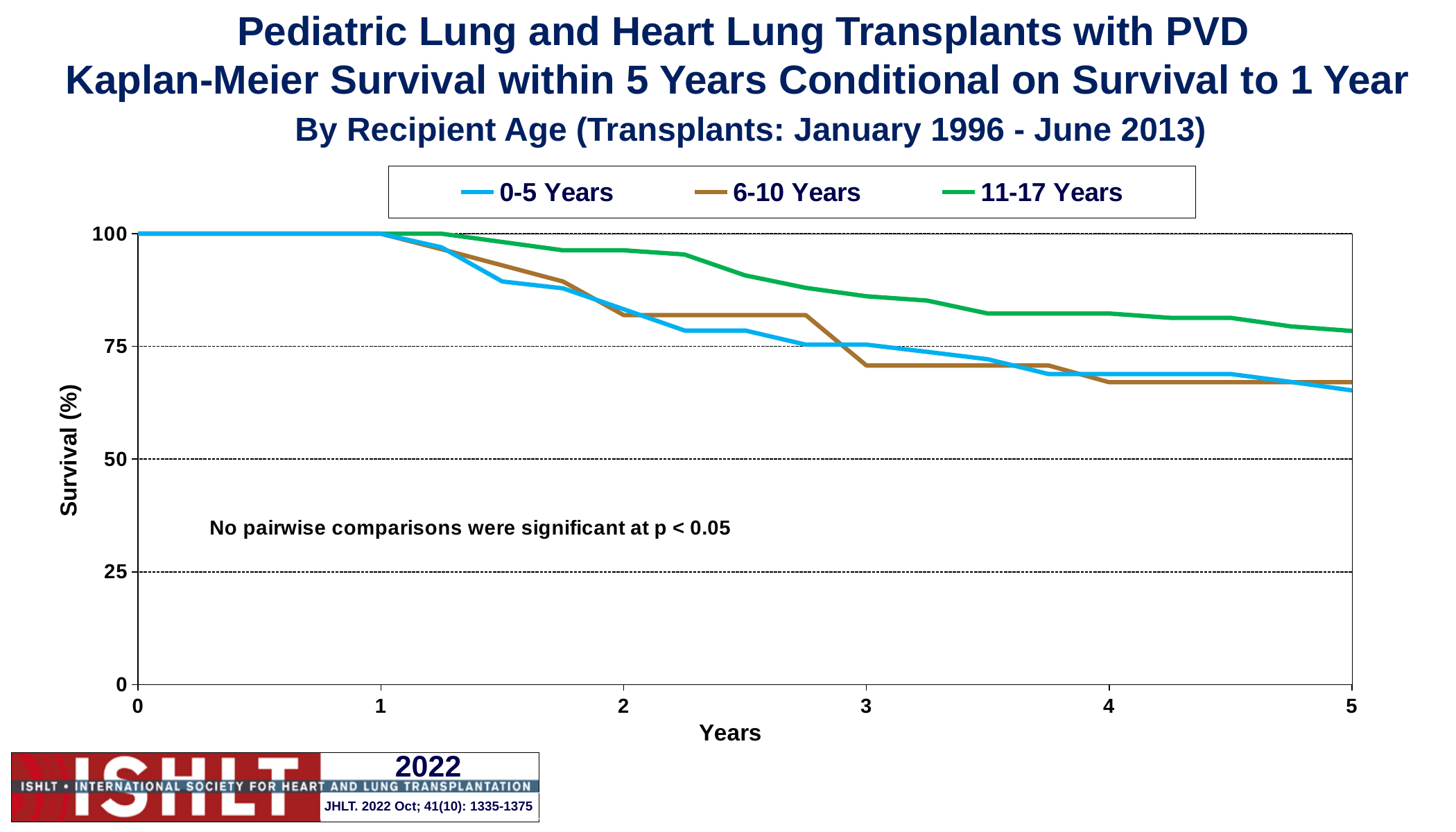
Which age group has the highest survival at year 5? 11-17 Years What kind of chart is shown on the slide? Line chart Is the survival for the 6-10 Years group at year 4 greater or less than 75? less What are the three recipient age groups listed in the legend? 0-5 Years, 6-10 Years, 11-17 Years At year 5, which group has higher survival: 11-17 Years or 0-5 Years? 11-17 Years Is the survival for the 11-17 Years group at year 3 greater or less than 75? greater What is the survival (%) for the 11-17 Years group at year 1? 100 How many series does the legend list? 3 Is the survival for the 11-17 Years group at year 5 greater or less than 75? greater What is the survival (%) for the 0-5 Years group at year 1? 100 Do the survival curves rise or fall as years increase? fall